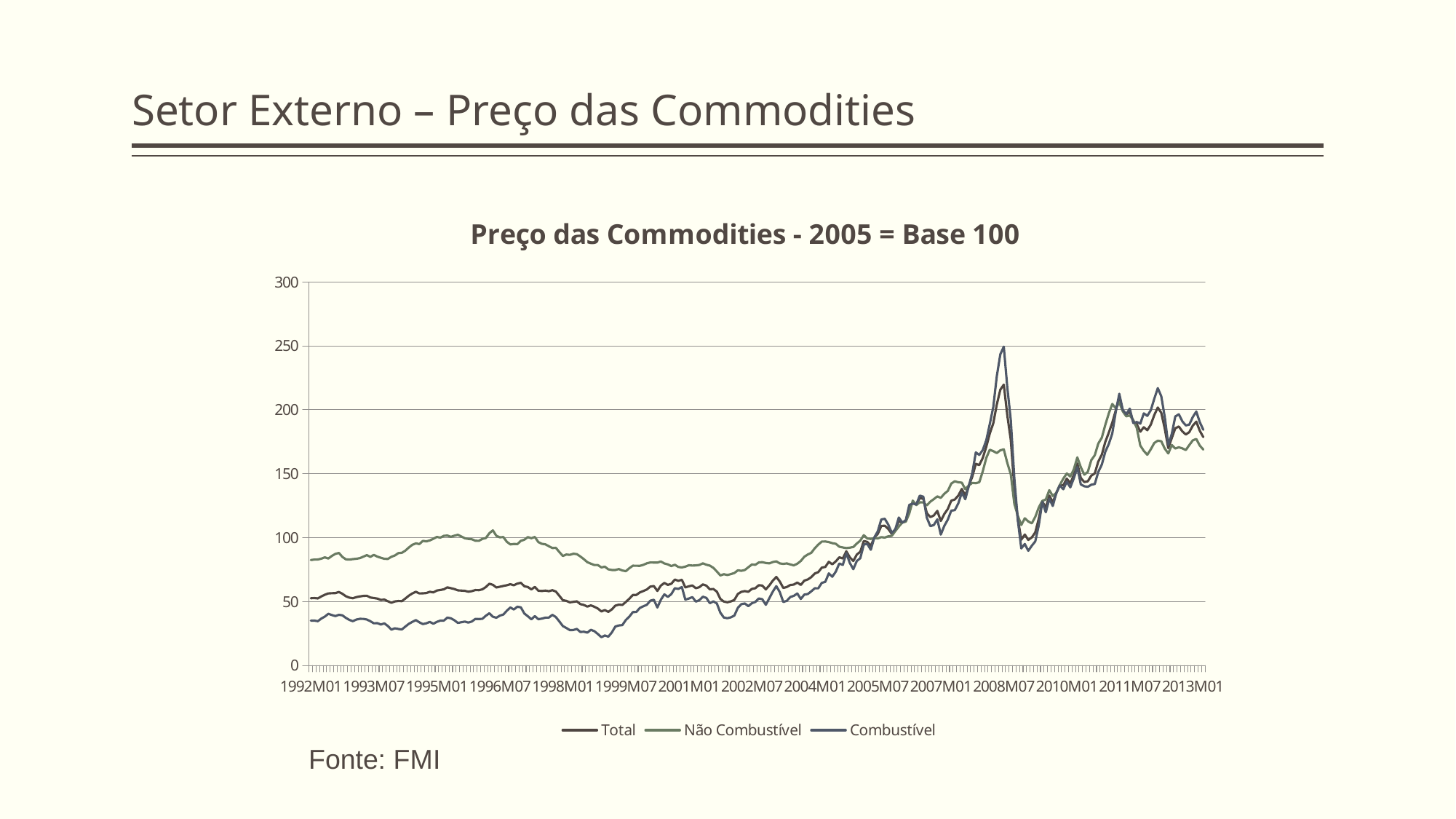
What source is cited below the chart? FMI Does the Total series generally rise or fall between 1999M07 and 2008M07? rise What kind of chart is shown on the slide? line chart Is the value of Combustível at 1992M01 greater or less than 50? less Which series reaches the highest value on the chart? Combustível Which series has the lowest value at 1992M01? Combustível Is the value of Não Combustível at 1992M01 greater or less than 50? greater What is the title of the chart? Preço das Commodities - 2005 = Base 100 At 1992M01, which is larger: Não Combustível or Combustível? Não Combustível Is the peak value of Combustível around 2008 greater or less than 200? greater How many series does the legend list? 3